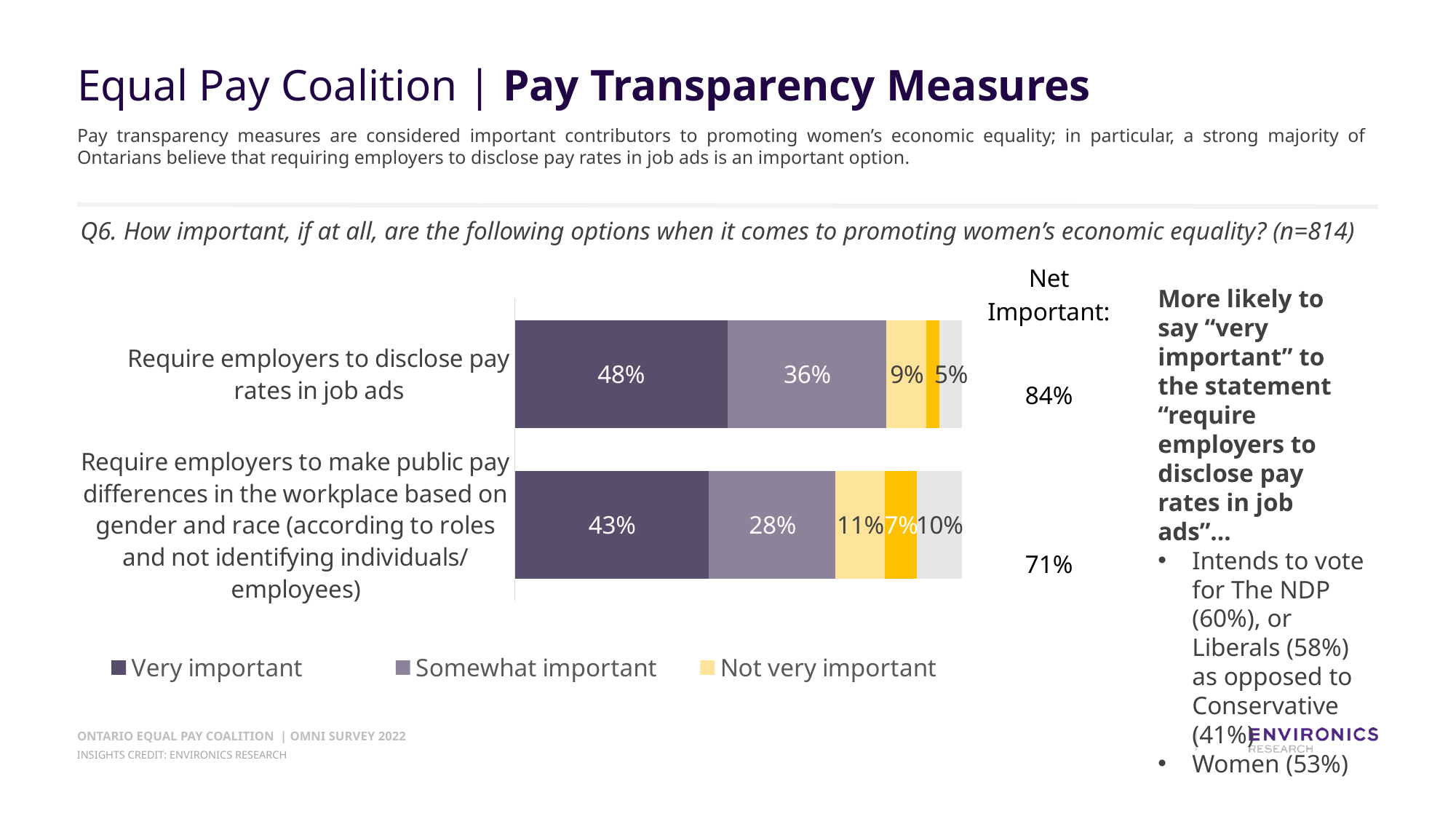
What type of chart is shown on the slide? Stacked bar chart What percentage of respondents said requiring employers to disclose pay rates in job ads is "very important"? 48% What percentage said requiring employers to make public pay differences in the workplace based on gender and race is "very important"? 43% What is the Net Important figure for requiring employers to make public pay differences in the workplace based on gender and race? 71% How many series does the legend list? 3 What is the difference in "very important" percentages between the two options? 5% How many options (categories) are shown in the chart? 2 What is the "somewhat important" value for requiring employers to disclose pay rates in job ads? 36% What is the difference between the two Net Important figures? 13% Which option has the higher "very important" share? Require employers to disclose pay rates in job ads What is the "somewhat important" value for requiring employers to make public pay differences in the workplace? 28% What is the Net Important figure for requiring employers to disclose pay rates in job ads? 84%